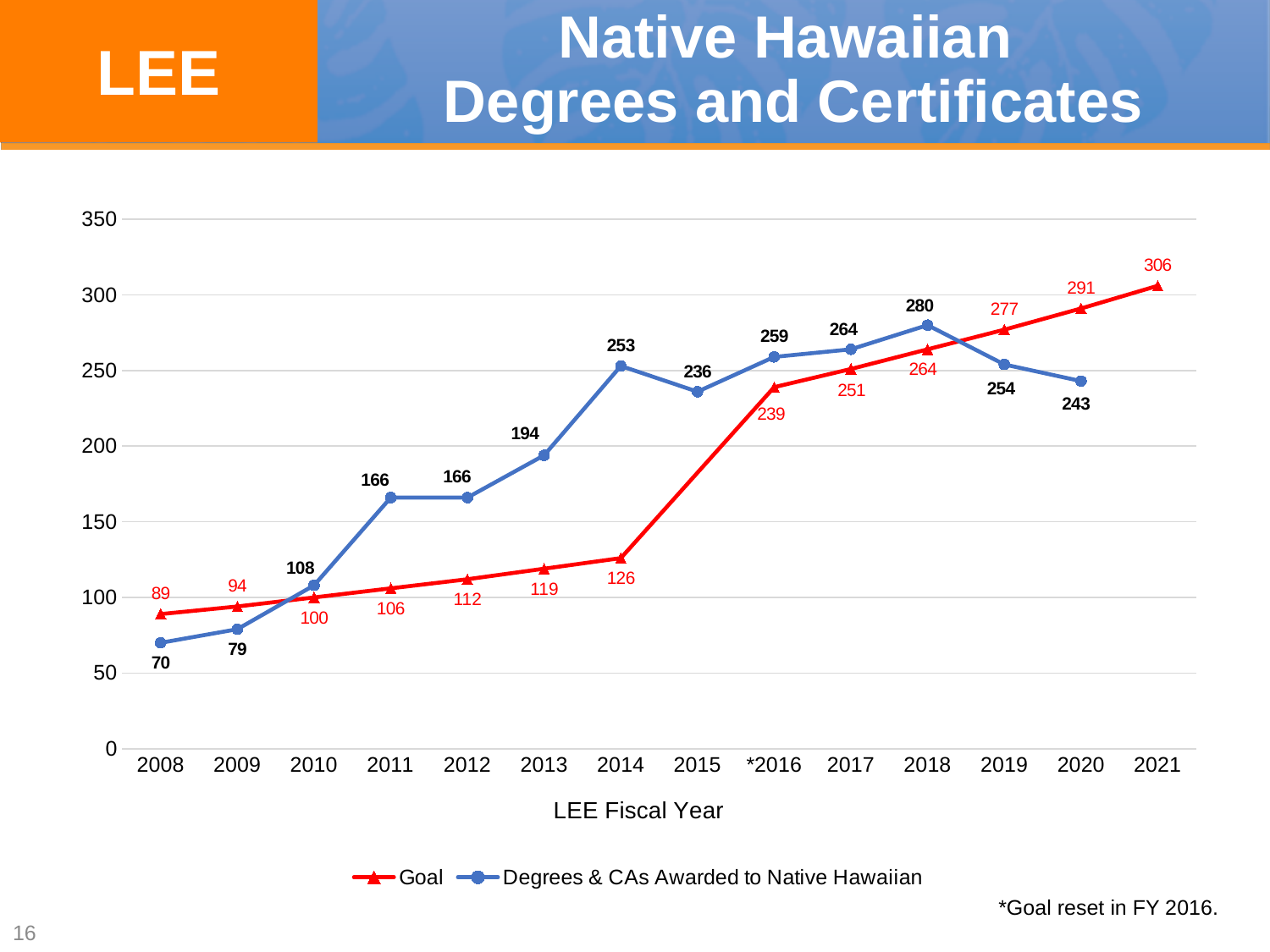
What was the number of Degrees & CAs Awarded to Native Hawaiian in 2014? 253 In which year was the number of Degrees & CAs Awarded to Native Hawaiian lowest? 2008 Does the Goal series rise or fall from 2008 to 2021? rise In which year did Degrees & CAs Awarded to Native Hawaiian reach its highest value? 2018 Is the Goal value for 2014 greater or less than 150? less How many fiscal years are shown on the x axis? 14 Which was larger in 2019, the Goal or the Degrees & CAs Awarded to Native Hawaiian? Goal What kind of chart is shown on the slide? line chart How many series does the legend list? 2 What is the Goal value for 2021? 306 What was the Goal value for 2008? 89 What is the difference between the Goal and the Degrees & CAs Awarded to Native Hawaiian in 2020? 48